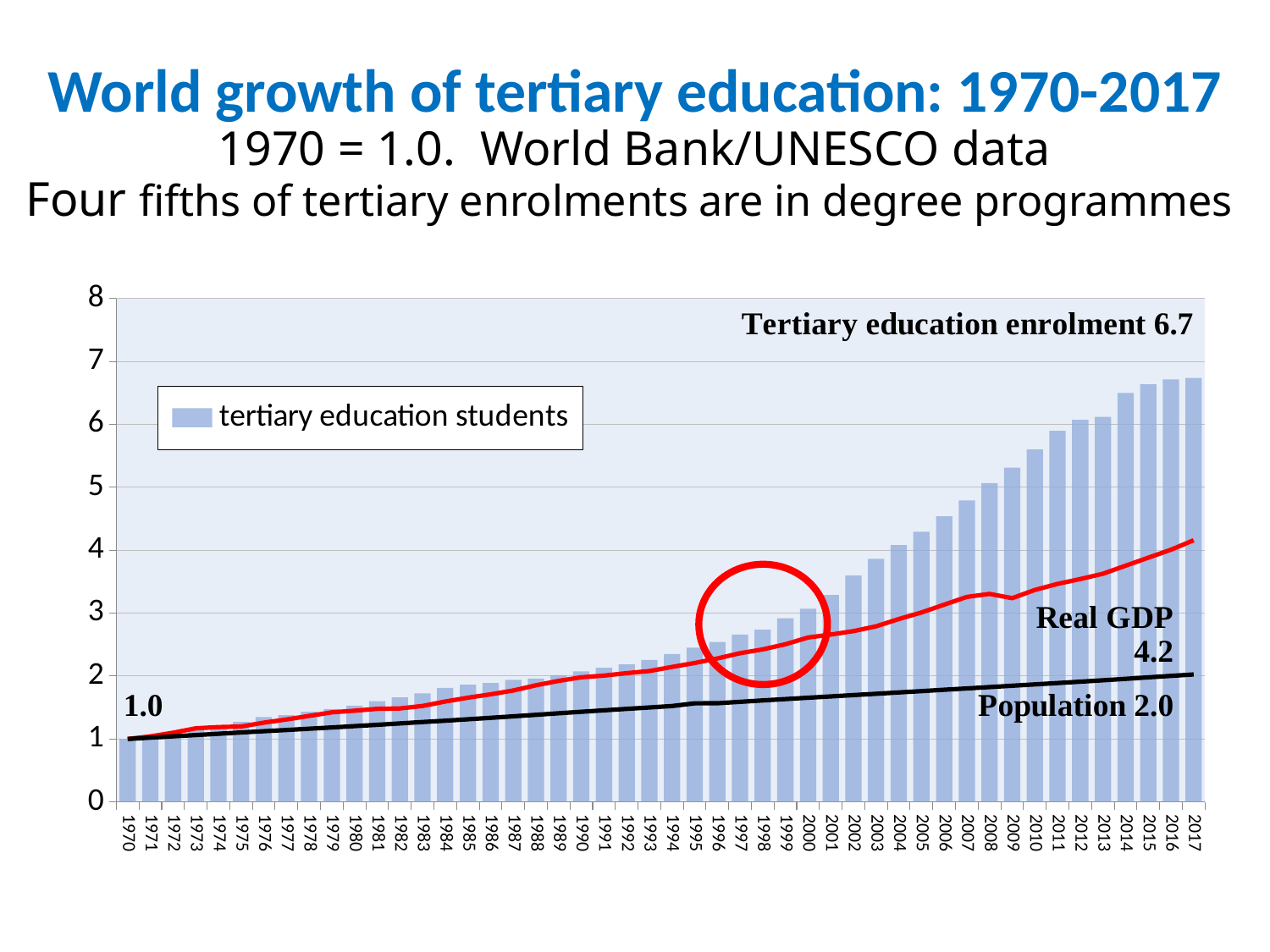
What is the tertiary education enrolment value shown for 2017? 6.7 In 2017, which is larger: tertiary education enrolment or Real GDP? Tertiary education enrolment What is the index value shown for 1970, the base year? 1.0 How many series does the chart's legend list? 1 Do the tertiary education students bars rise or fall from 1970 to 2017? Rise Is the tertiary education students bar for 2010 greater or less than 5? greater What is the Population value shown for 2017? 2.0 Is the tertiary education students bar for 1980 greater or less than 2? less What is the difference between the 2017 Real GDP value (4.2) and the 2017 Population value (2.0)? 2.2 What is the difference between the 2017 tertiary education enrolment value (6.7) and the 2017 Real GDP value (4.2)? 2.5 How many years are shown on the x axis of the chart? 48 What is the Real GDP value shown at the end of the series in 2017? 4.2